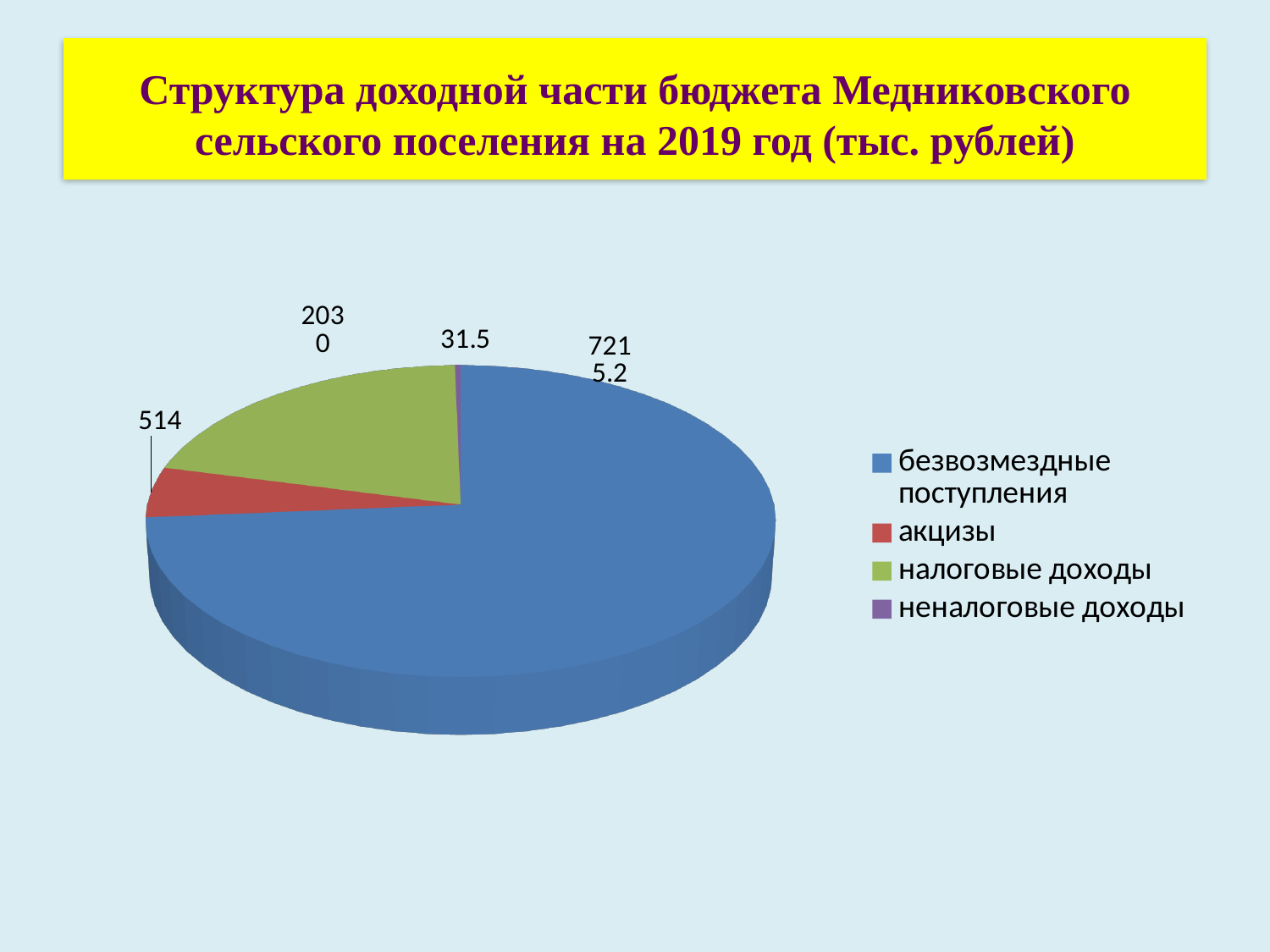
What is the value for акцизы? 514 Which is larger, the value for акцизы or the value for неналоговые доходы? акцизы Which is larger, the value for акцизы or the value for налоговые доходы? налоговые доходы In what units are the values in the chart given, according to the slide title? тыс. рублей How many entries does the legend list? 4 Which category has the smallest slice of the pie? неналоговые доходы Which category has the largest slice of the pie? безвозмездные поступления What colour is the slice for налоговые доходы? green What is the difference between the value for акцизы and the value for неналоговые доходы? 482.5 What kind of chart is shown on the slide? pie chart How many slices does the pie chart have? 4 What is the value for неналоговые доходы? 31.5